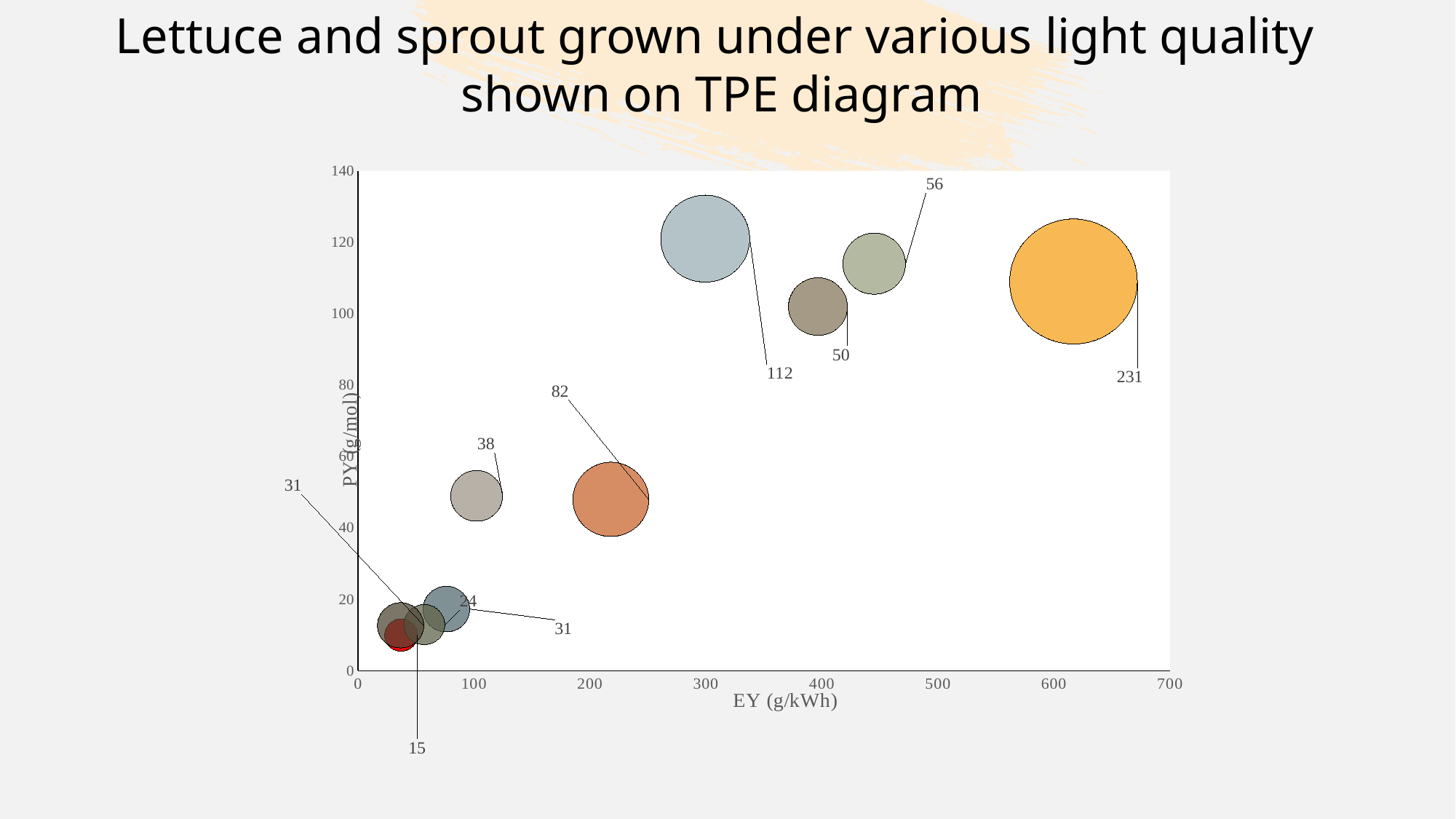
Is the EY value of the bubble labelled 38 greater or less than 200? less Is the PY value of the bubble labelled 82 greater or less than 60? less Which bubble label is larger, 112 or 82? 112 How many labelled bubbles are plotted on the chart? 10 What is the largest bubble label value shown on the chart? 231 Is the PY value of the bubble labelled 112 greater or less than 100? greater What is the difference between the largest bubble label (231) and the smallest bubble label (15)? 216 What is the label of the x axis of the chart? EY (g/kWh) What is the title of the chart on the slide? Lettuce and sprout grown under various light quality shown on TPE diagram What kind of chart is shown on the slide? bubble chart What is the smallest bubble label value shown on the chart? 15